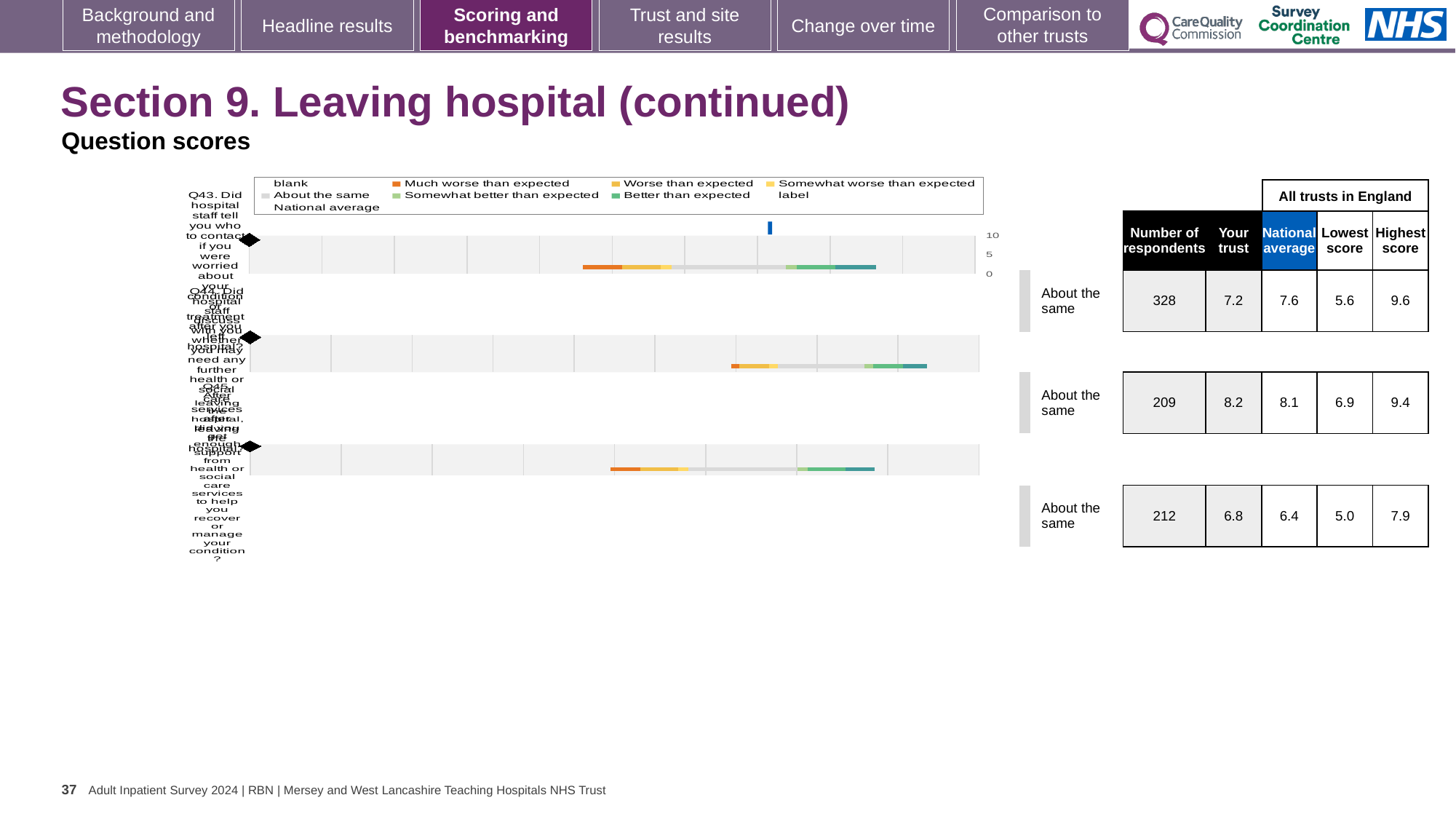
For Q43, what is the difference between the highest score and the lowest score across all trusts in England? 4.0 Which question has the highest 'Your trust' score in the table next to the chart? Q44 Is the 'Your trust' score for Q45 greater or less than 5? greater For Q43, which is larger: the 'Your trust' score or the national average? National average How many respondents are listed for Q45 in the table next to the chart? 212 Which question has the lowest 'Your trust' score in the table next to the chart? Q45 How many questions (Q43, Q44, Q45) are plotted as separate bars on the slide? 3 What is the 'Your trust' score for Q43 shown in the table next to the chart? 7.2 What kind of chart is used to show the question scores on this slide? bar chart What is the national average score for Q44 shown in the table next to the chart? 8.1 What benchmark category is shown beside the Q43 bar? About the same What colour does the legend use for 'Much worse than expected'? Orange